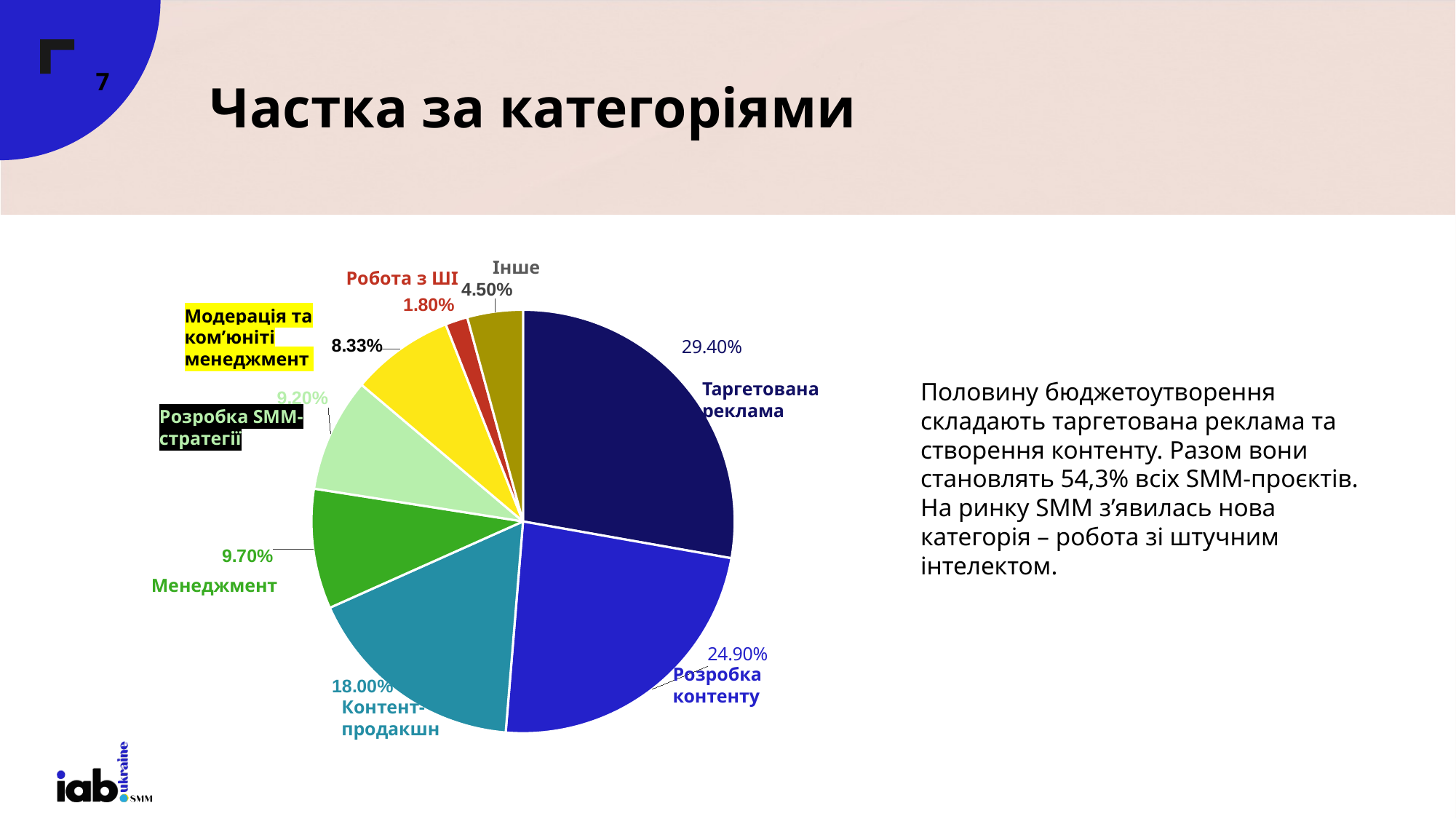
What share does the slice for Таргетована реклама have? 29.40% What is the title of the slide containing the pie chart? Частка за категоріями What share does the slice for Контент-продакшн have? 18.00% What share does the slice for Робота з ШІ have? 1.80% What share does the slice for Розробка контенту have? 24.90% Which category has the smallest slice of the pie? Робота з ШІ Which is larger, the share for Менеджмент or the share for Розробка SMM-стратегії? Менеджмент What is the difference between the shares of Таргетована реклама and Розробка контенту? 4.50% What share does the slice for Модерація та ком’юніті менеджмент have? 8.33% How many slices does the pie chart have? 8 What kind of chart is shown on the slide? pie chart Which category has the largest slice of the pie? Таргетована реклама